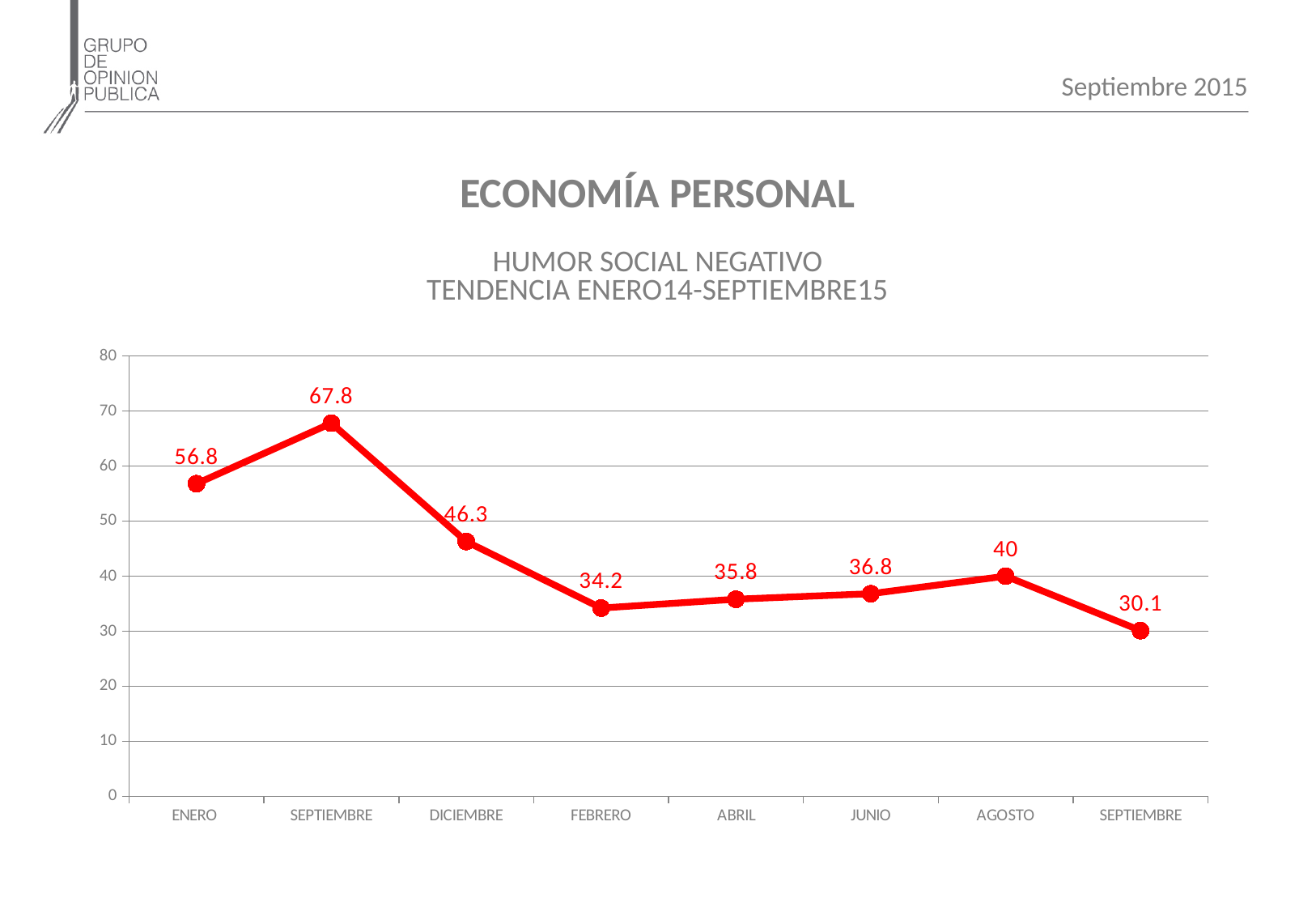
What is the difference between the AGOSTO value and the last SEPTIEMBRE value? 9.9 Which category has the lowest value? SEPTIEMBRE (30.1) What kind of chart is shown on the slide? line chart What is the difference between the first SEPTIEMBRE value and the ENERO value? 11 What is the value for AGOSTO? 40 Which is larger, the value for FEBRERO or the value for JUNIO? JUNIO What is the value for DICIEMBRE? 46.3 Which category has the highest value? SEPTIEMBRE (67.8) Is the value for DICIEMBRE greater or less than 50? less How many data points are plotted on the chart? 8 What is the value for ENERO? 56.8 Do the values rise or fall from FEBRERO to AGOSTO? rise